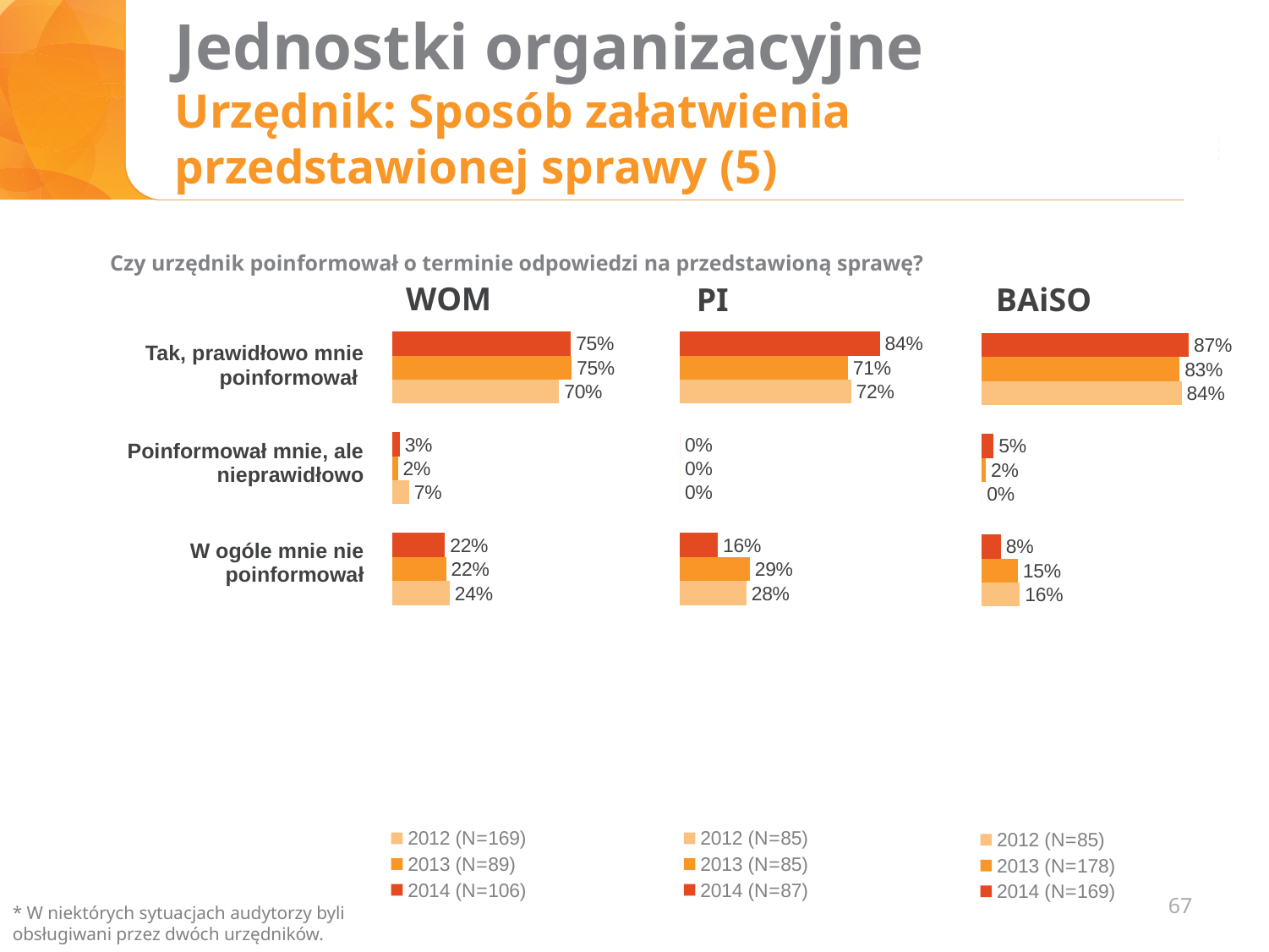
In the BAiSO chart, what is the value for 2012 for "Tak, prawidłowo mnie poinformował"? 84% In the WOM chart, which is larger for "W ogóle mnie nie poinformował": the 2012 value or the 2014 value? 2012 In the PI chart, which year has the lowest value for "W ogóle mnie nie poinformował"? 2014 In the BAiSO chart, what is the difference between the 2014 and 2013 values for "Tak, prawidłowo mnie poinformował"? 4% In the WOM chart, what is the value for 2014 for "Tak, prawidłowo mnie poinformował"? 75% In the PI chart, what is the difference between the 2014 and 2013 values for "Tak, prawidłowo mnie poinformował"? 13% In the BAiSO chart, which year has the highest value for "Tak, prawidłowo mnie poinformował"? 2014 How many series does the legend of the PI chart list? 3 In the PI chart, what is the value for 2013 for "W ogóle mnie nie poinformował"? 29% How many categories are shown in the WOM chart? 3 In the WOM chart, what is the value for 2012 for "Poinformował mnie, ale nieprawidłowo"? 7% What kind of chart is the BAiSO chart? Bar chart